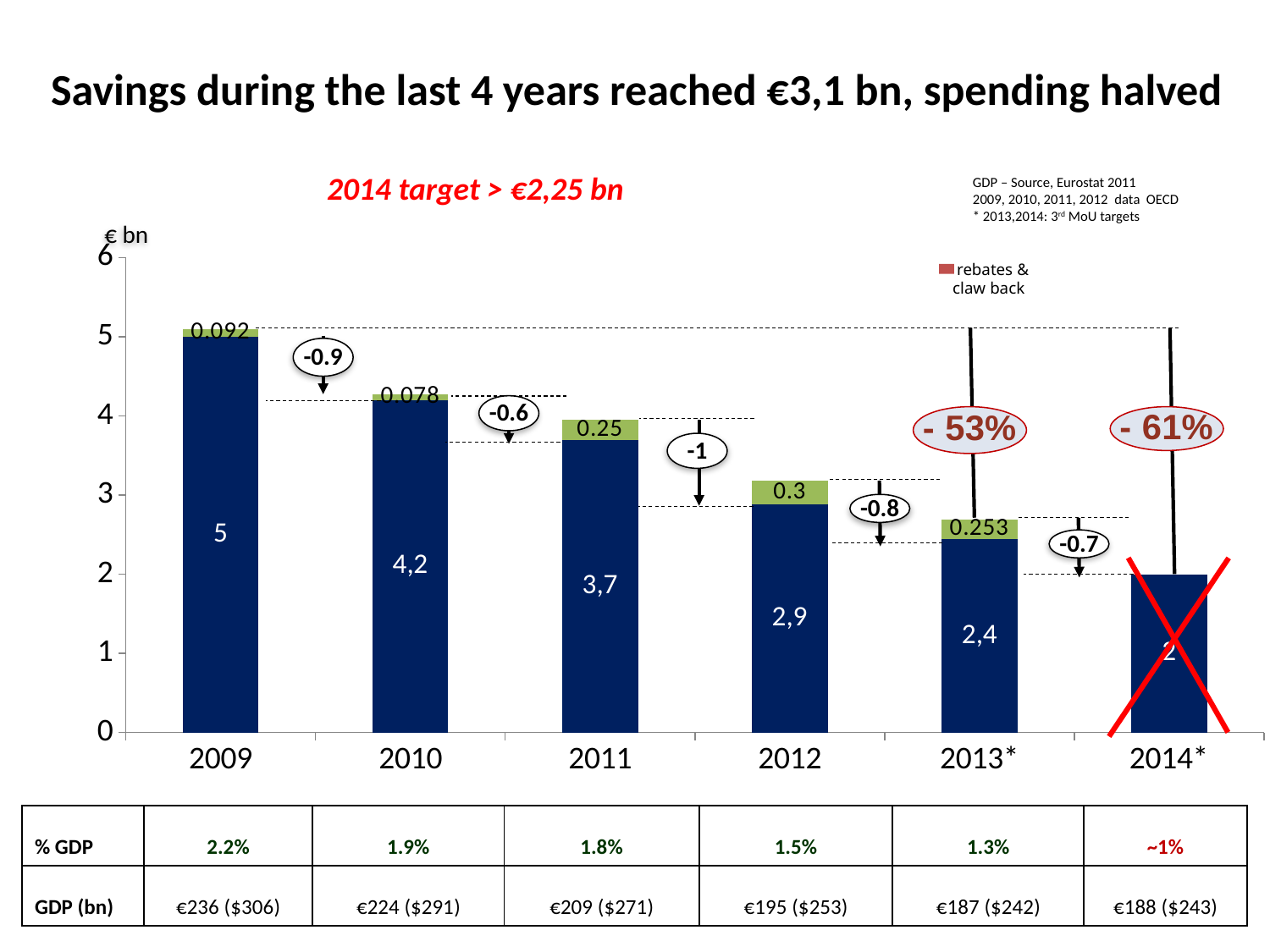
Which is larger, the dark blue bar value for 2011 or for 2012? 2011 What is the value printed on the dark blue bar for 2011? 3,7 Which year has the lowest dark blue bar? 2014* What is the value printed on the dark blue bar for 2009? 5 What is the value of the green 'rebates & claw back' segment for 2013*? 0.253 What kind of chart is shown on the slide? bar chart Which year has the highest dark blue bar? 2009 How many years are shown on the x axis of the chart? 6 Is the total height of the 2013* bar greater or less than 3? less What is the value of the green 'rebates & claw back' segment for 2012? 0.3 Do the dark blue bar values rise or fall from 2009 to 2014*? fall What is the difference between the dark blue bar values for 2009 and 2014*? 3